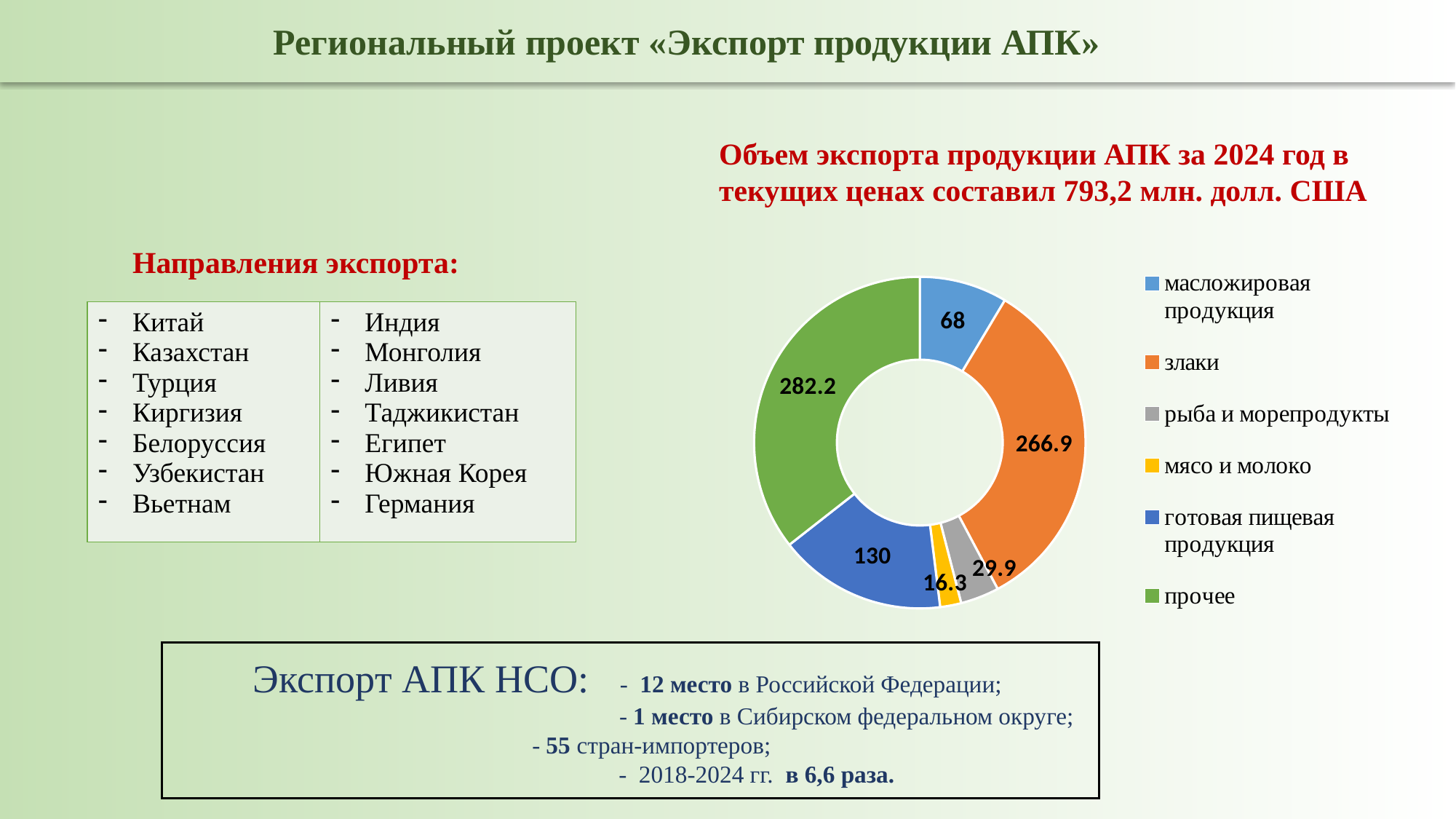
Which colour represents злаки in the doughnut chart? Orange How many categories does the doughnut chart show? 6 What is the value for готовая пищевая продукция in the doughnut chart? 130 What is the difference between the values for готовая пищевая продукция and масложировая продукция? 62 What is the value for злаки in the doughnut chart? 266.9 What type of chart is shown on the slide? Doughnut (pie) chart What is the value for мясо и молоко in the doughnut chart? 16.3 Which is larger: рыба и морепродукты or мясо и молоко? рыба и морепродукты What is the value for масложировая продукция in the doughnut chart? 68 Which category has the smallest value in the doughnut chart? мясо и молоко Which category has the largest value in the doughnut chart? прочее What is the difference between the values for прочее and злаки? 15.3